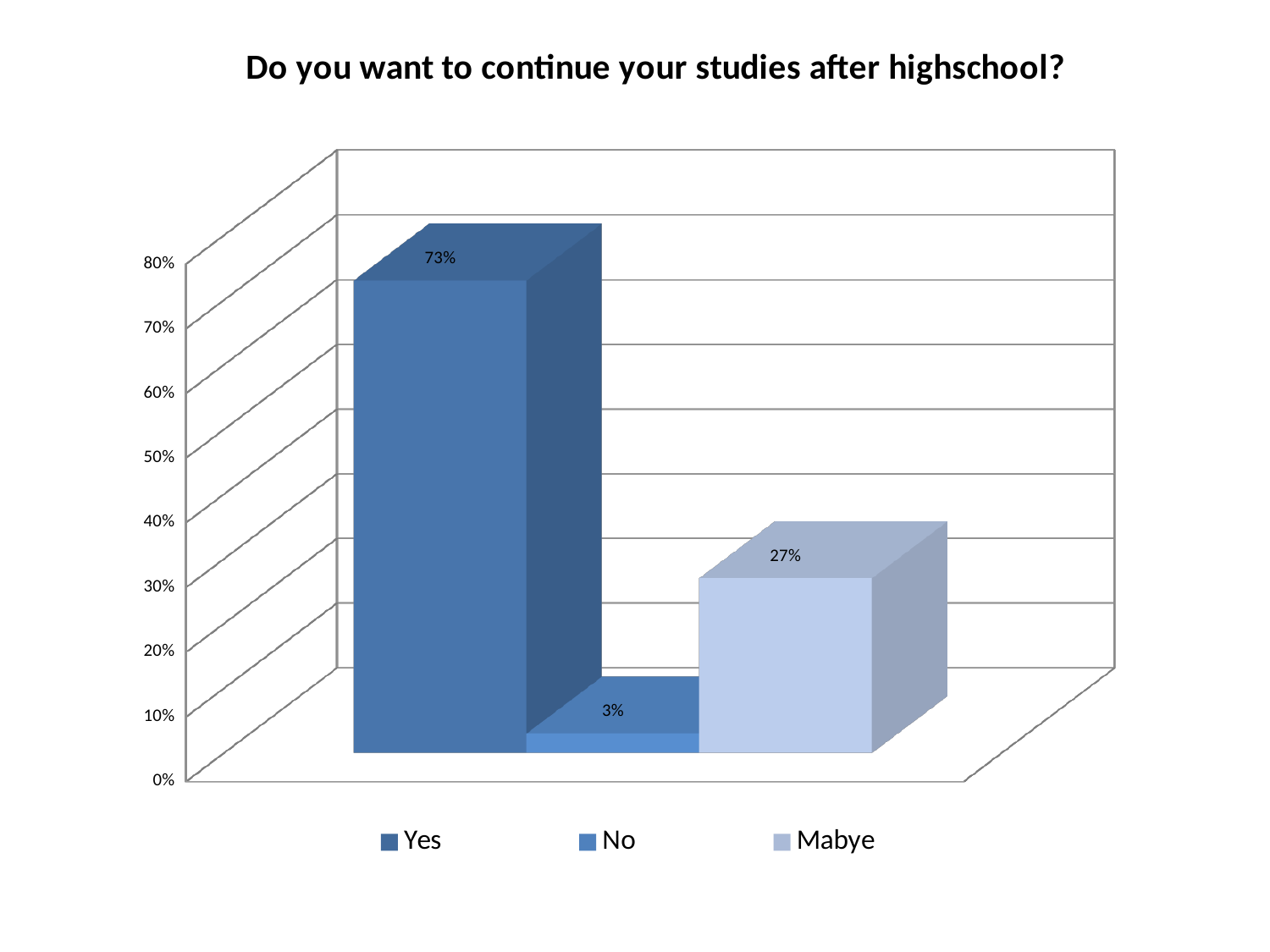
How many entries does the legend list? 3 What percentage of respondents answered No? 3% Which response has the highest percentage? Yes What is the difference between the Mabye and No percentages? 24% Which response has the lowest percentage? No What is the title of the chart? Do you want to continue your studies after highschool? Which is larger, the value for Mabye or the value for No? Mabye How many response categories are shown in the chart? 3 What kind of chart is shown on the slide? Bar chart What is the difference between the Yes and Mabye percentages? 46% What percentage of respondents answered Mabye? 27% What percentage of respondents answered Yes? 73%